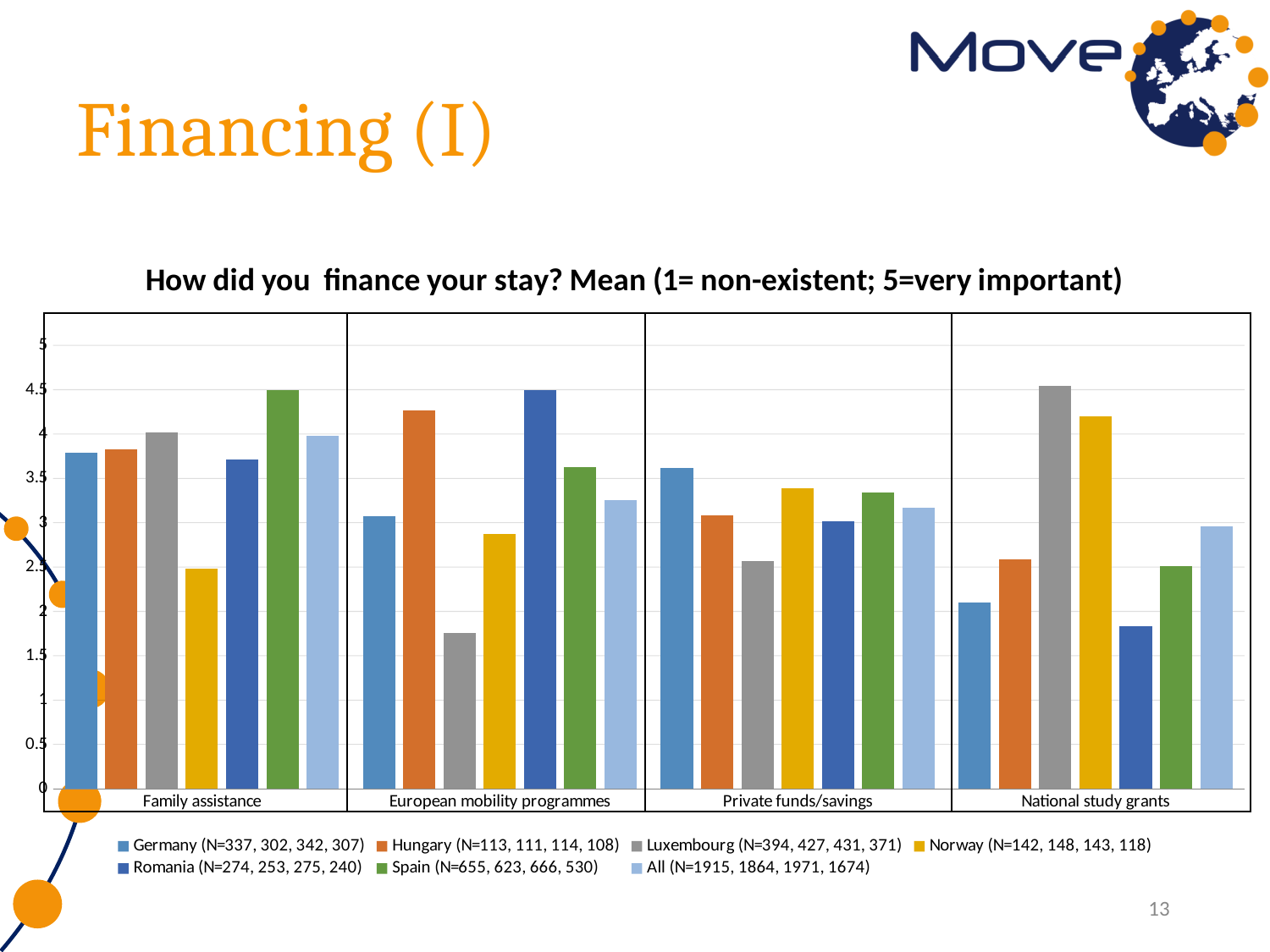
How many series does the legend list? 7 Which country has the lowest bar for Family assistance? Norway Is the value for Luxembourg under European mobility programmes greater or less than 2? less Which country has the lowest bar for European mobility programmes? Luxembourg Which country has the highest bar for National study grants? Luxembourg How many financing categories are shown on the x axis? 4 What kind of chart is shown on the slide? Bar chart Which country has the highest bar for European mobility programmes? Romania Which country has the highest bar for Family assistance? Spain Is the value for Norway under Family assistance greater or less than 3? less Which country has the lowest bar for National study grants? Romania For Private funds/savings, which is larger: the value for Germany or the value for Hungary? Germany